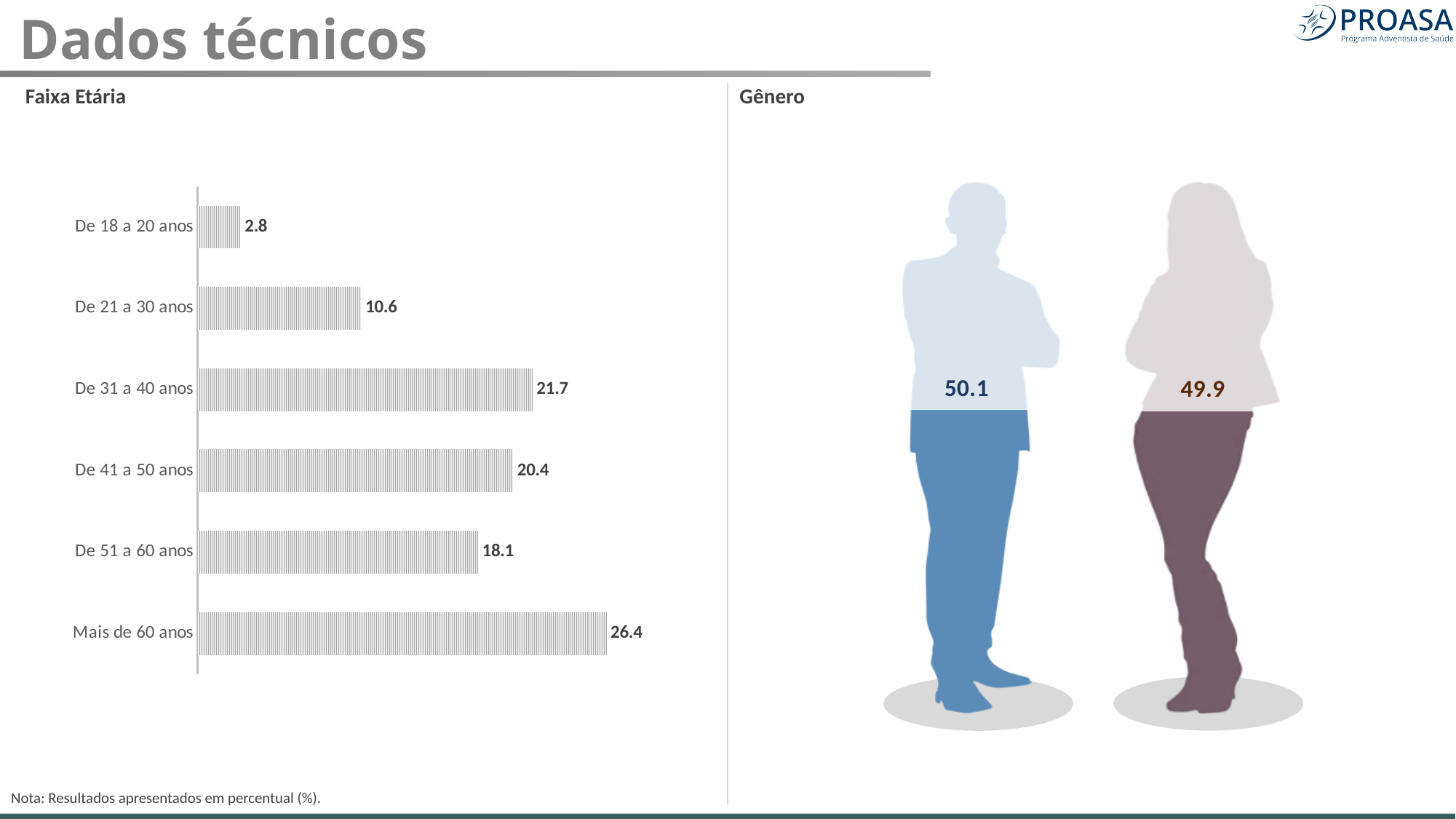
How many age groups are shown in the Faixa Etária chart? 6 In the Faixa Etária chart, which is larger: the value for De 21 a 30 anos or De 51 a 60 anos? De 51 a 60 anos In the Gênero graphic, what is the value shown for the female figure? 49.9 In the Faixa Etária chart, what is the value for Mais de 60 anos? 26.4 In the Faixa Etária chart, which age group has the lowest value? De 18 a 20 anos What kind of chart is the Faixa Etária chart? Bar chart In the Faixa Etária chart, what is the difference between the values for De 41 a 50 anos and De 51 a 60 anos? 2.3 In the Faixa Etária chart, what is the value for De 31 a 40 anos? 21.7 In the Gênero graphic, what is the value shown for the male figure? 50.1 In the Faixa Etária chart, which age group has the highest value? Mais de 60 anos In the Faixa Etária chart, what is the value for De 18 a 20 anos? 2.8 In the Gênero graphic, what is the difference between the male and female values? 0.2